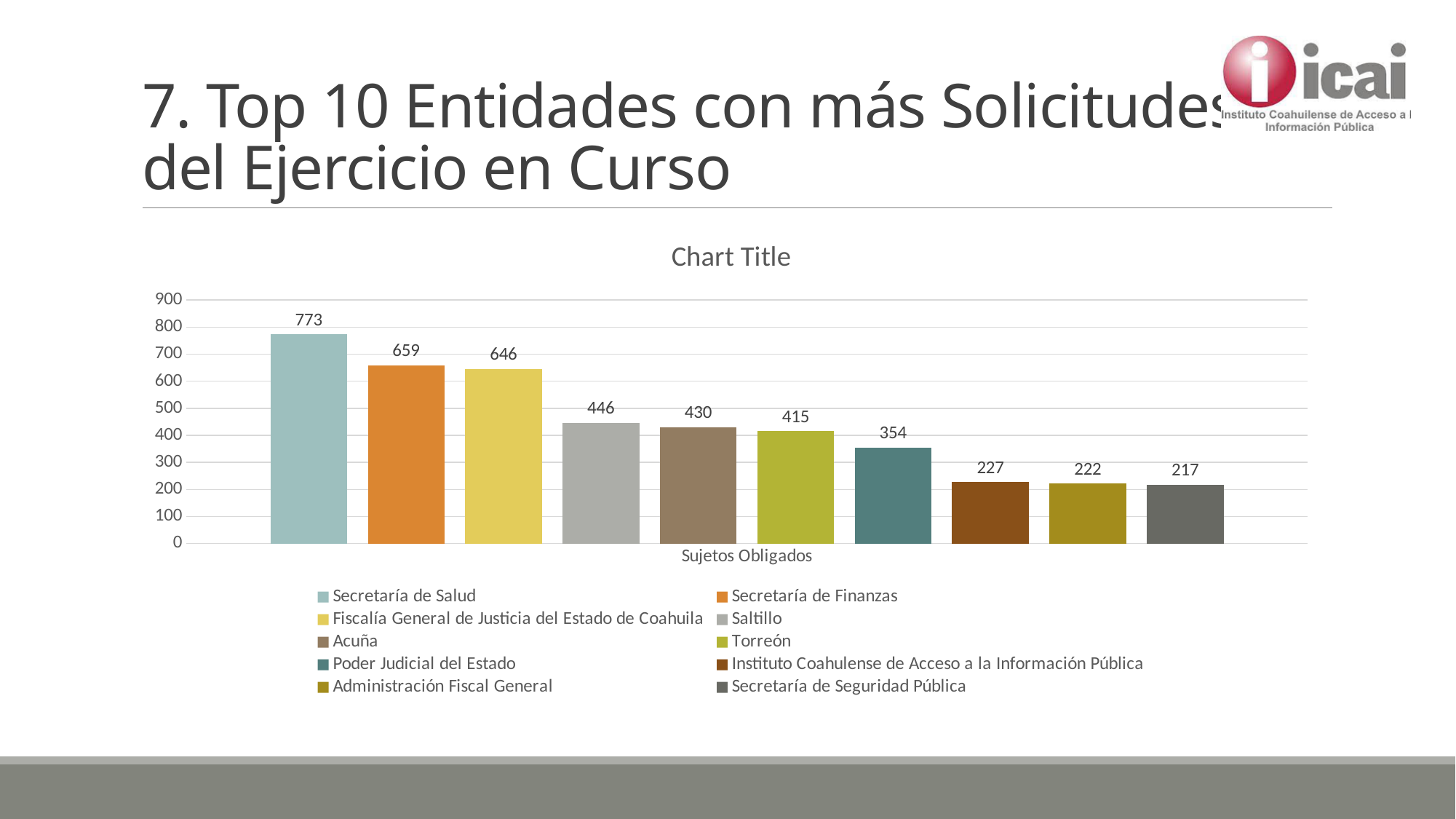
Which entity has the lowest value? Secretaría de Seguridad Pública What is the value for Secretaría de Salud? 773 What is the difference between the values for Secretaría de Salud and Secretaría de Finanzas? 114 Is the value for Fiscalía General de Justicia del Estado de Coahuila greater or less than 600? greater How many bars are plotted in the chart? 10 What is the value for Poder Judicial del Estado? 354 Which entity has the highest value? Secretaría de Salud How many series does the legend list? 10 Which is larger, the value for Acuña or the value for Torreón? Acuña What is the value for Administración Fiscal General? 222 What is the value for Saltillo? 446 What kind of chart is shown on the slide? Bar chart